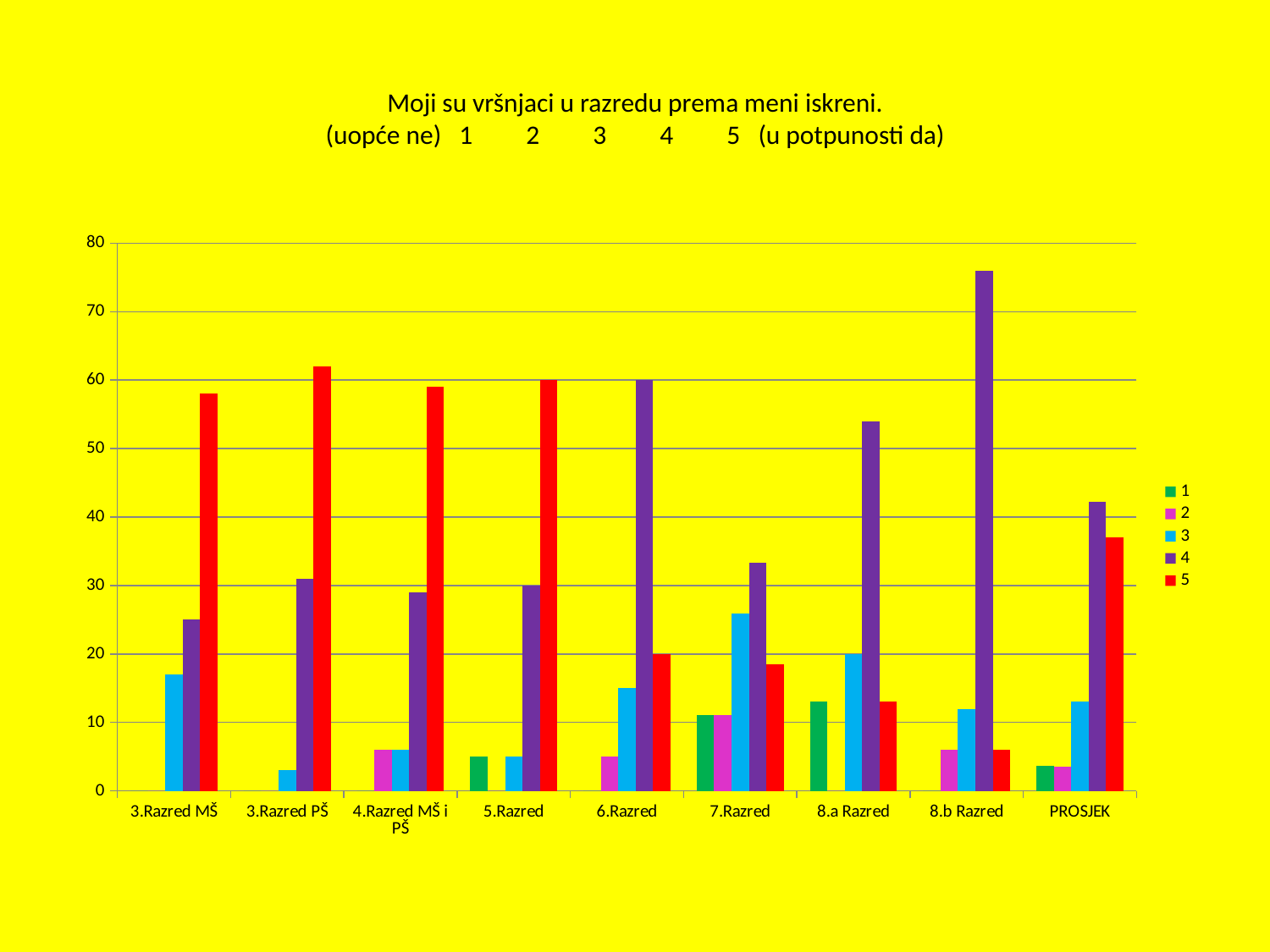
Which is larger: series 3 in 6.Razred or series 3 in 7.Razred? 7.Razred Is the value for series 4 in 8.b Razred greater or less than 70? greater What kind of chart is shown on the slide? bar chart Is the value for series 5 in 3.Razred MŠ greater or less than 50? greater What is the title of the chart? Moji su vršnjaci u razredu prema meni iskreni. Is the value for series 4 in PROSJEK greater or less than 40? greater Which is larger: series 4 in 8.a Razred or series 4 in 8.b Razred? 8.b Razred Which category has the tallest bar for series 4? 8.b Razred How many categories are shown along the x axis? 9 How many series does the legend list? 5